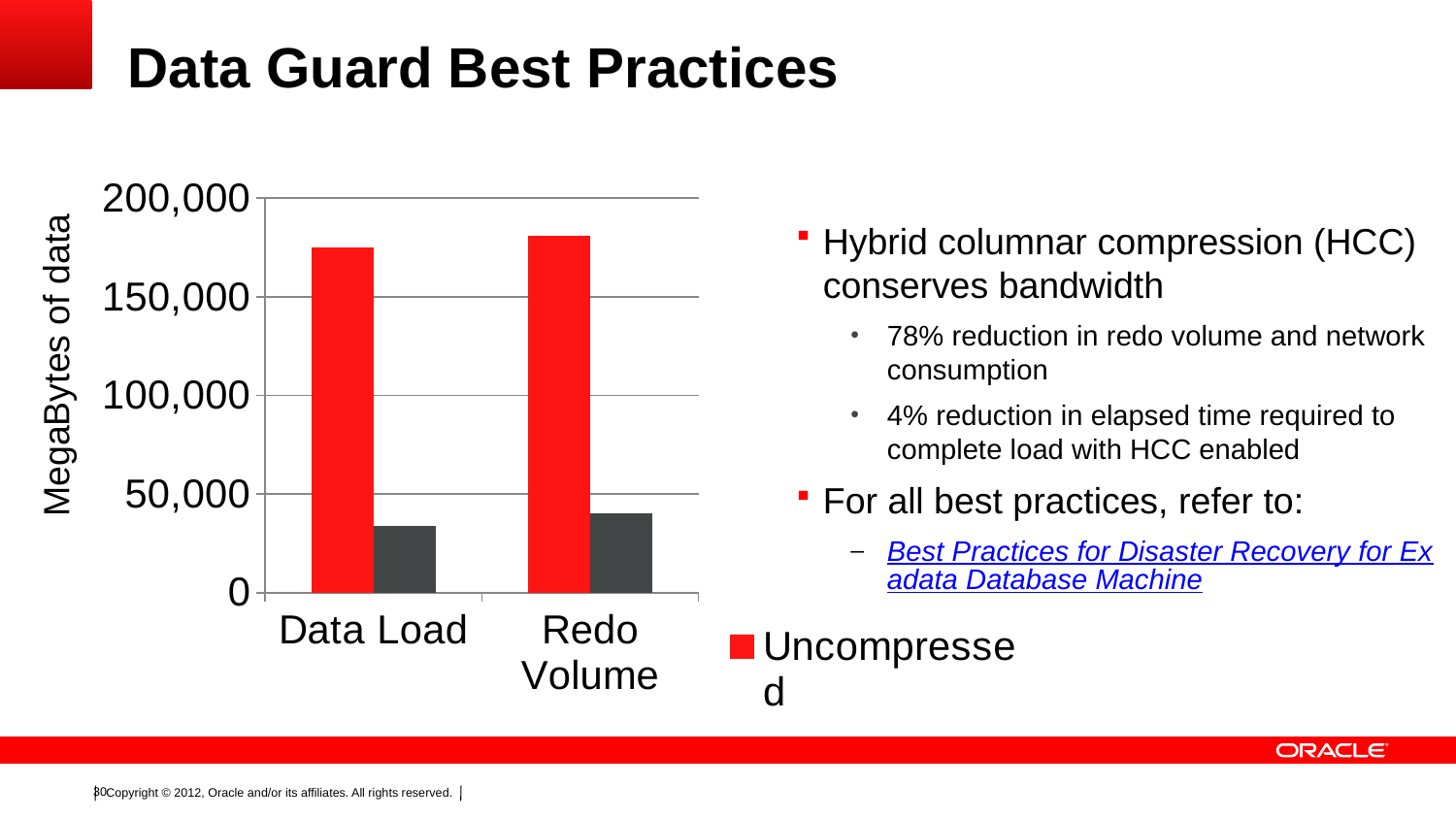
What kind of chart is shown on the slide? bar chart Is the value of the dark grey bar for Redo Volume greater or less than 100,000? less Is the Uncompressed value for Data Load greater or less than 200,000? less For Data Load, which bar is larger, the Uncompressed (red) bar or the dark grey bar? Uncompressed (red) How many categories are shown on the x axis of the chart? 2 Is the Uncompressed value for Redo Volume greater or less than 150,000? greater What colour are the Uncompressed bars in the chart? red For Redo Volume, which bar is larger, the Uncompressed (red) bar or the dark grey bar? Uncompressed (red) What is the title of the vertical axis of the chart? MegaBytes of data